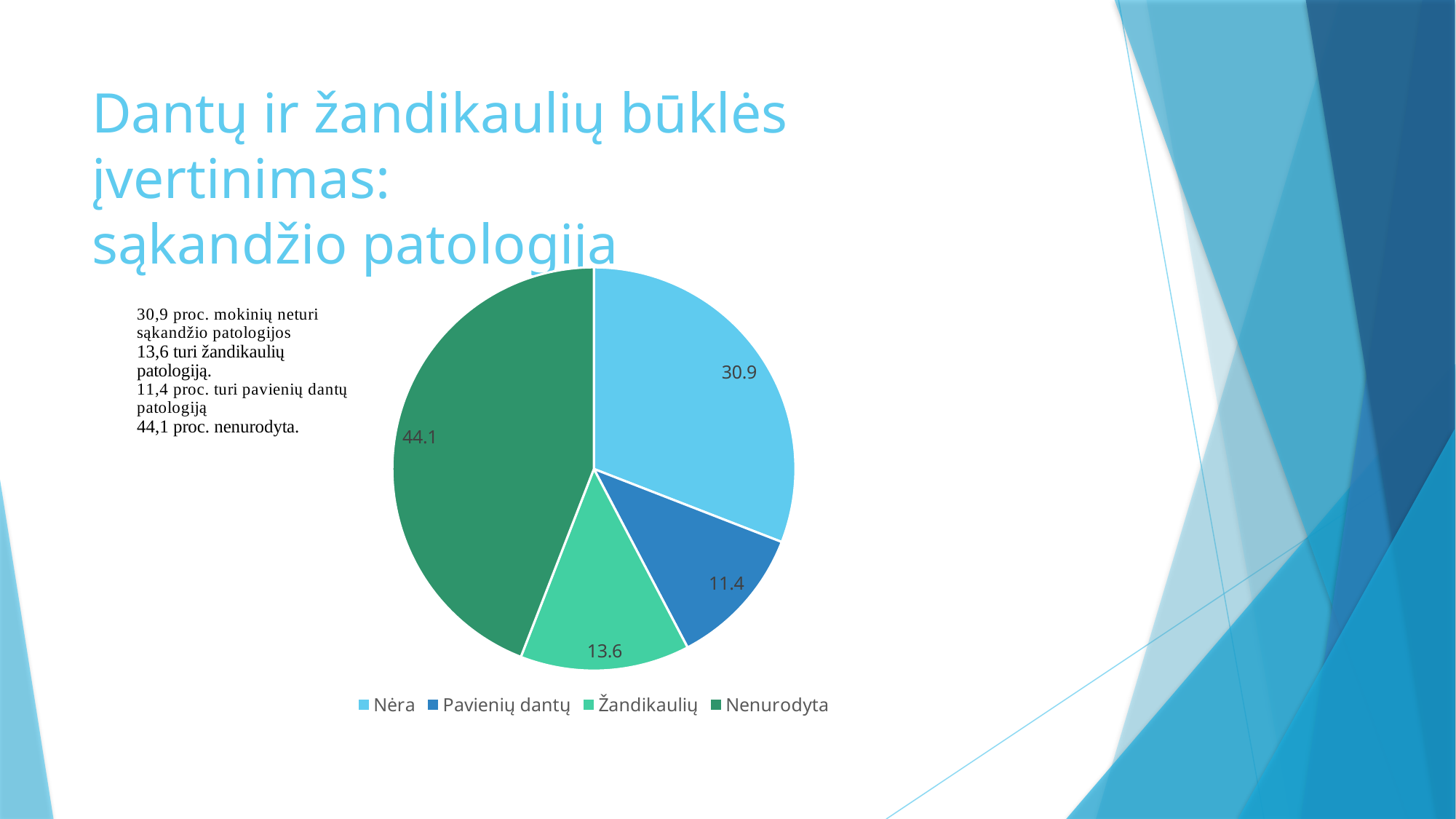
What is the value for Pavienių dantų in the pie chart? 11.4 What is the difference between the values for Žandikaulių and Pavienių dantų? 2.2 What is the value for Nenurodyta in the pie chart? 44.1 Which category has the smallest slice in the pie chart? Pavienių dantų What is the value for Žandikaulių in the pie chart? 13.6 Which is larger, the value for Nėra or the value for Žandikaulių? Nėra What is the value for Nėra in the pie chart? 30.9 Which category has the largest slice in the pie chart? Nenurodyta What colour is the Nenurodyta slice in the pie chart? dark green What is the difference between the values for Nenurodyta and Nėra? 13.2 What type of chart is shown on the slide? pie chart How many categories does the pie chart have? 4